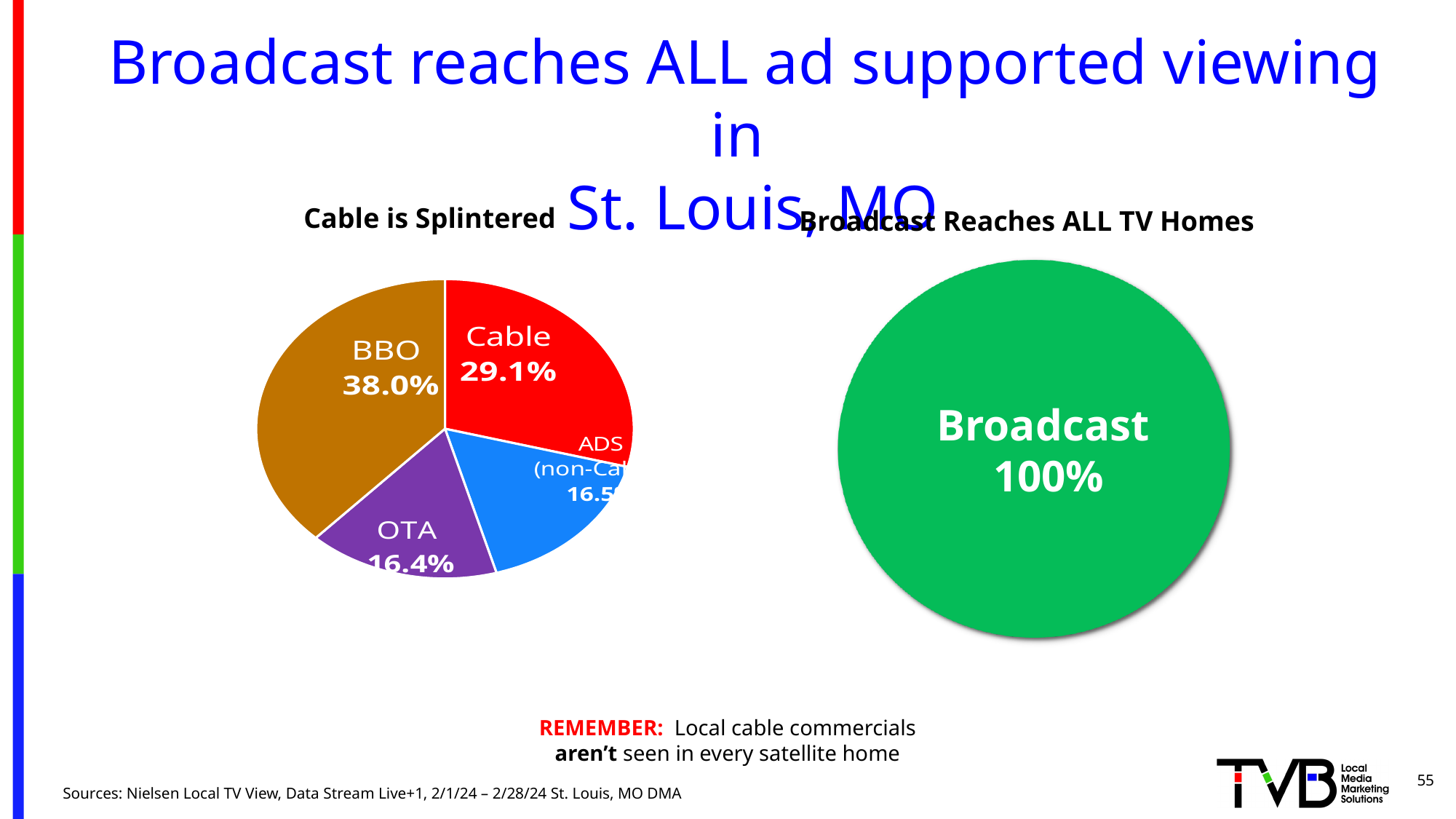
In the 'Broadcast Reaches ALL TV Homes' chart, what value is shown for Broadcast? 100% What is the title of the chart on the left side of the slide? Cable is Splintered In the 'Cable is Splintered' pie chart, what is the value shown for BBO? 38.0% In the 'Cable is Splintered' pie chart, which is larger, Cable or OTA? Cable In the 'Cable is Splintered' pie chart, which slice is the largest? BBO What kind of chart is the 'Cable is Splintered' chart? Pie chart In the 'Cable is Splintered' pie chart, what is the value shown for OTA? 16.4% In the 'Cable is Splintered' pie chart, what is the difference between the BBO and Cable values? 8.9 percentage points In the 'Cable is Splintered' pie chart, what is the value shown for Cable? 29.1% How many slices does the 'Cable is Splintered' pie chart have? 4 In the 'Cable is Splintered' pie chart, what is the difference between the Cable and OTA values? 12.7 percentage points In the 'Cable is Splintered' pie chart, which is larger, BBO or Cable? BBO